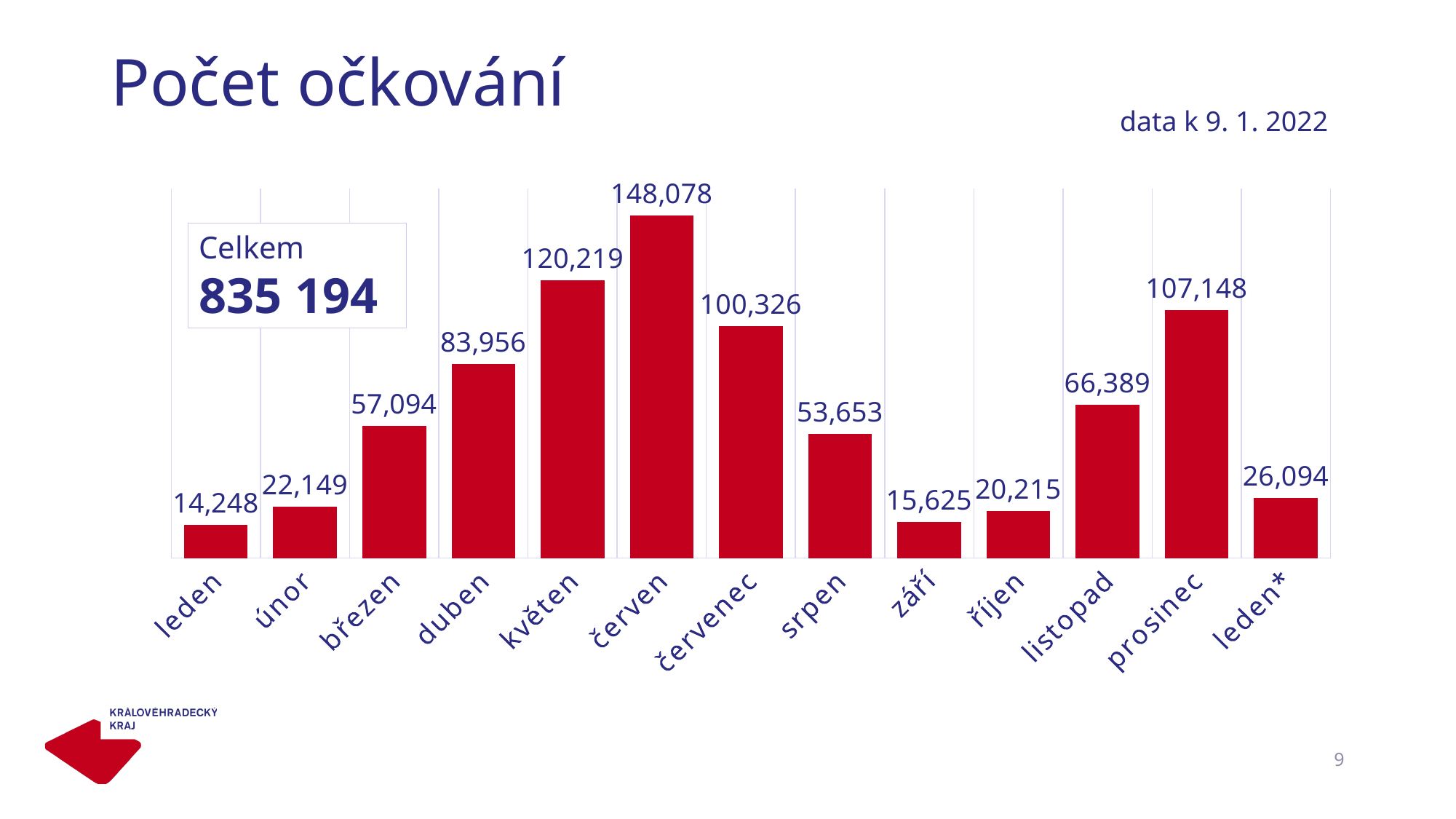
What is the difference between the values for prosinec and listopad? 40,759 Which month has the lowest value? leden What is the value for leden*? 26,094 Which month has the highest value? červen What kind of chart is shown on the slide? bar chart What total (Celkem) is shown in the box on the chart? 835 194 What is the value for prosinec? 107,148 Which is larger, the value for duben or the value for červenec? červenec How many bars are shown in the chart? 13 What is the value for červen? 148,078 Which is larger, the value for září or the value for říjen? říjen What is the difference between the values for červen and květen? 27,859